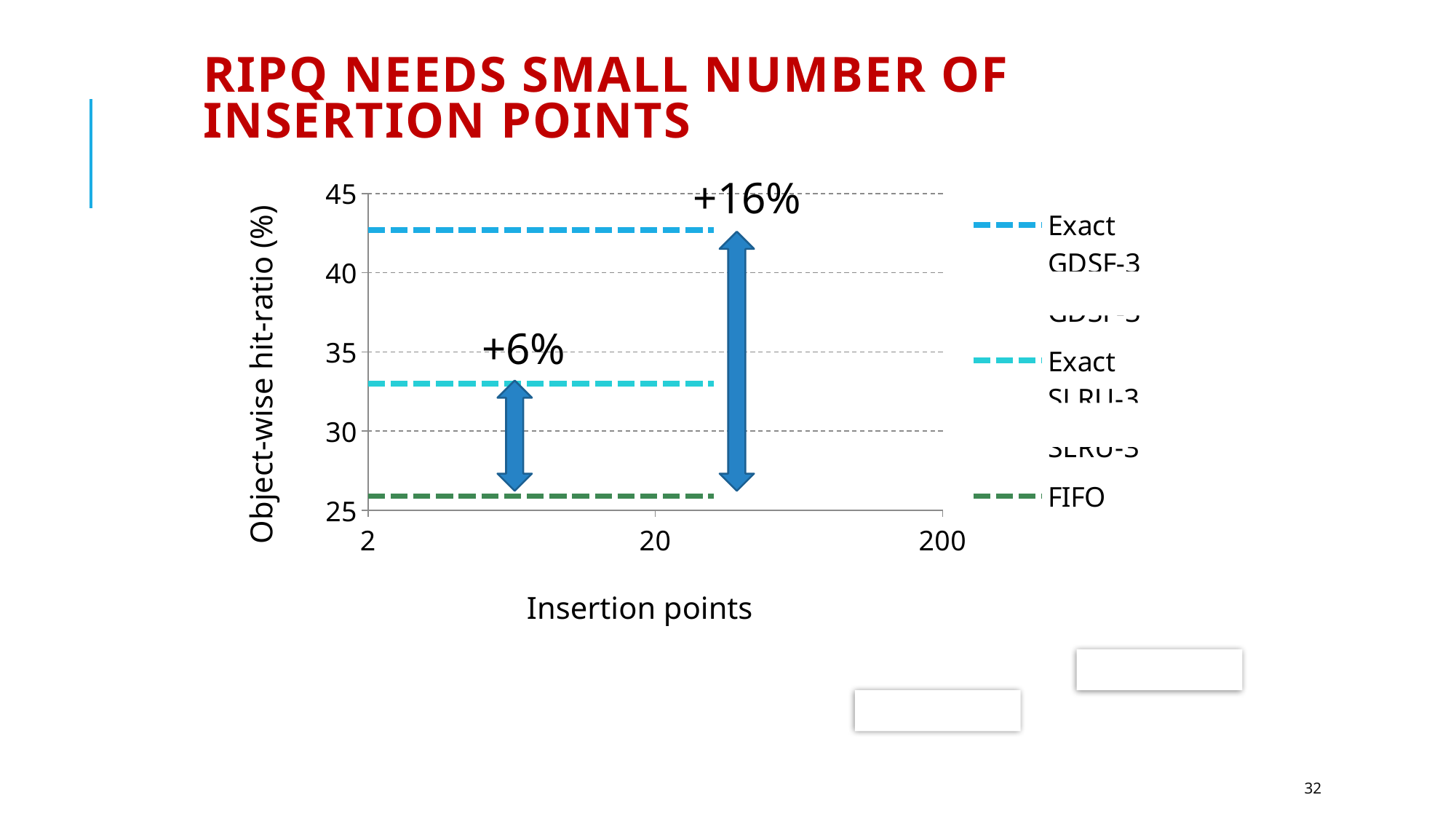
What improvement is annotated between the FIFO line and the Exact SLRU-3 line? +6% Which series has the highest object-wise hit-ratio? Exact GDSF-3 Is the value for Exact GDSF-3 greater or less than 40? greater Is the value for Exact GDSF-3 greater or less than 45? less Is the value for Exact SLRU-3 greater or less than 30? greater What is the label of the x axis? Insertion points Which is larger, the hit-ratio for Exact SLRU-3 or for FIFO? Exact SLRU-3 Which series has the lowest object-wise hit-ratio? FIFO Do the dashed lines rise, fall, or stay flat as the number of insertion points increases? stay flat What kind of chart is shown on the slide? line chart What improvement is annotated between the FIFO line and the Exact GDSF-3 line? +16%